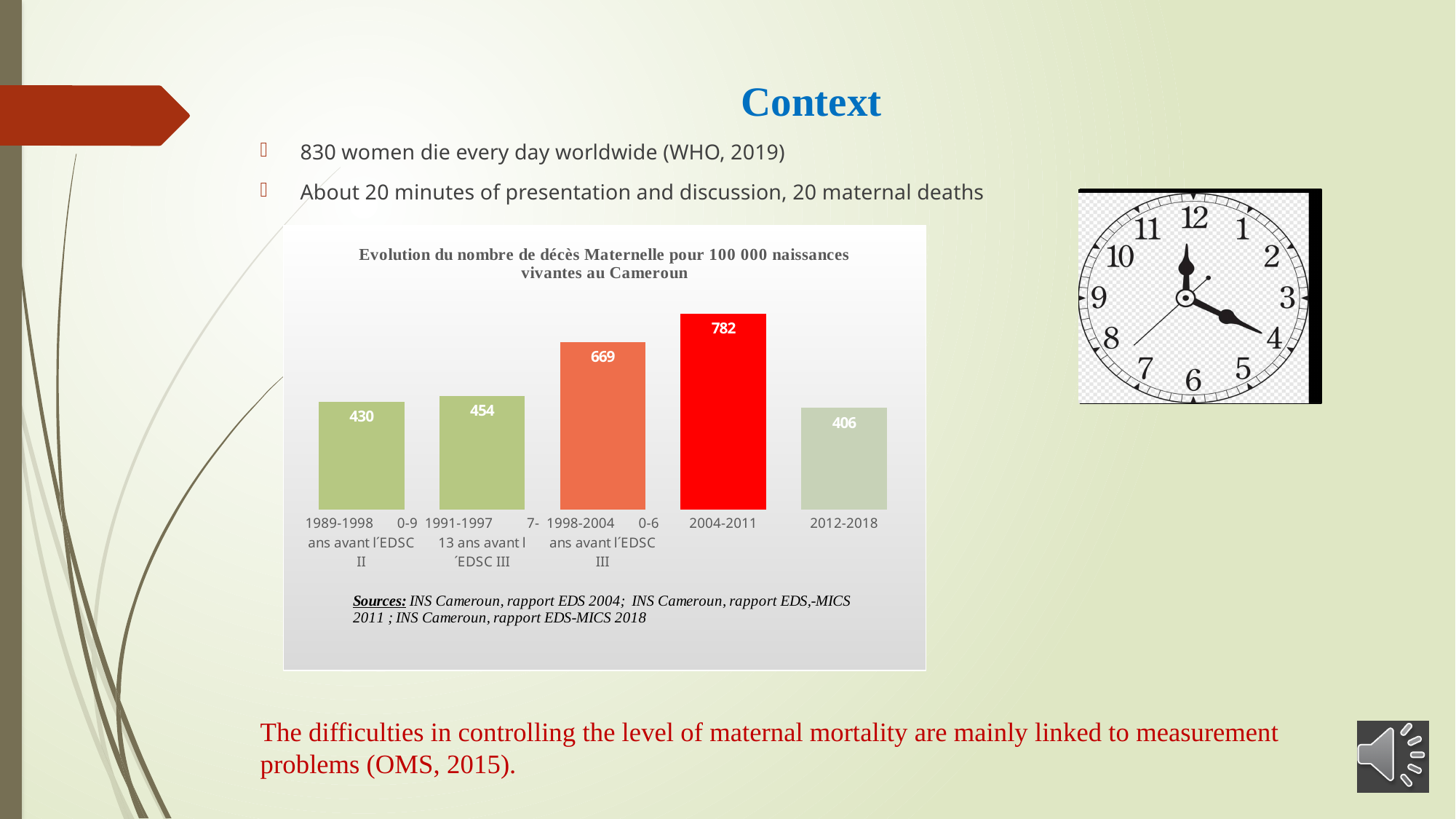
What kind of chart is shown on the slide? Bar chart Do the values rise or fall from the 1989-1998 bar to the 2004-2011 bar? Rise What is the title of the chart? Evolution du nombre de décès Maternelle pour 100 000 naissances vivantes au Cameroun What is the value for the 1998-2004 period? 669 What is the value for the 2012-2018 bar? 406 Which is larger, the value for 1998-2004 or the value for 2004-2011? 2004-2011 Which period has the highest number of maternal deaths per 100 000 live births? 2004-2011 What is the difference between the 2004-2011 value and the 2012-2018 value? 376 Which period has the lowest value in the chart? 2012-2018 What is the difference between the 1991-1997 value and the 1989-1998 value? 24 How many bars are shown in the chart? 5 What is the value for the 2004-2011 bar? 782